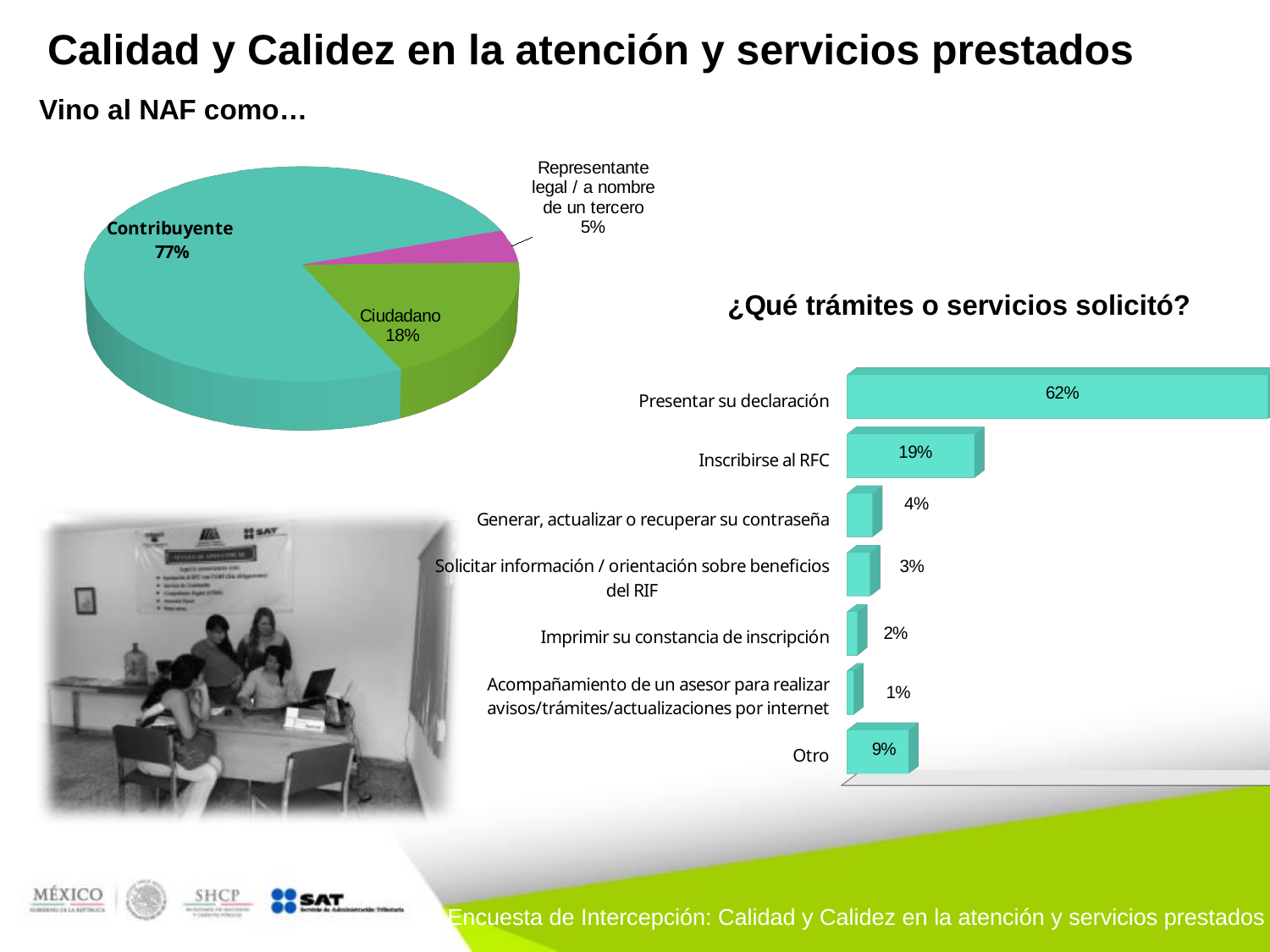
In the pie chart 'Vino al NAF como…', what share is labelled for Ciudadano? 18% In the bar chart '¿Qué trámites o servicios solicitó?', which category has the lowest value? Acompañamiento de un asesor para realizar avisos/trámites/actualizaciones por internet In the bar chart '¿Qué trámites o servicios solicitó?', how many categories are shown? 7 In the pie chart 'Vino al NAF como…', how many slices are there? 3 In the pie chart 'Vino al NAF como…', what share is labelled for Contribuyente? 77% In the bar chart '¿Qué trámites o servicios solicitó?', what is the difference between Presentar su declaración and Inscribirse al RFC? 43% In the bar chart '¿Qué trámites o servicios solicitó?', what is the value for Otro? 9% What kind of chart is '¿Qué trámites o servicios solicitó?'? Bar chart In the bar chart '¿Qué trámites o servicios solicitó?', what is the value for Presentar su declaración? 62% In the pie chart 'Vino al NAF como…', which category has the largest slice? Contribuyente In the bar chart '¿Qué trámites o servicios solicitó?', what is the value for Inscribirse al RFC? 19% In the pie chart 'Vino al NAF como…', what share is labelled for Representante legal / a nombre de un tercero? 5%